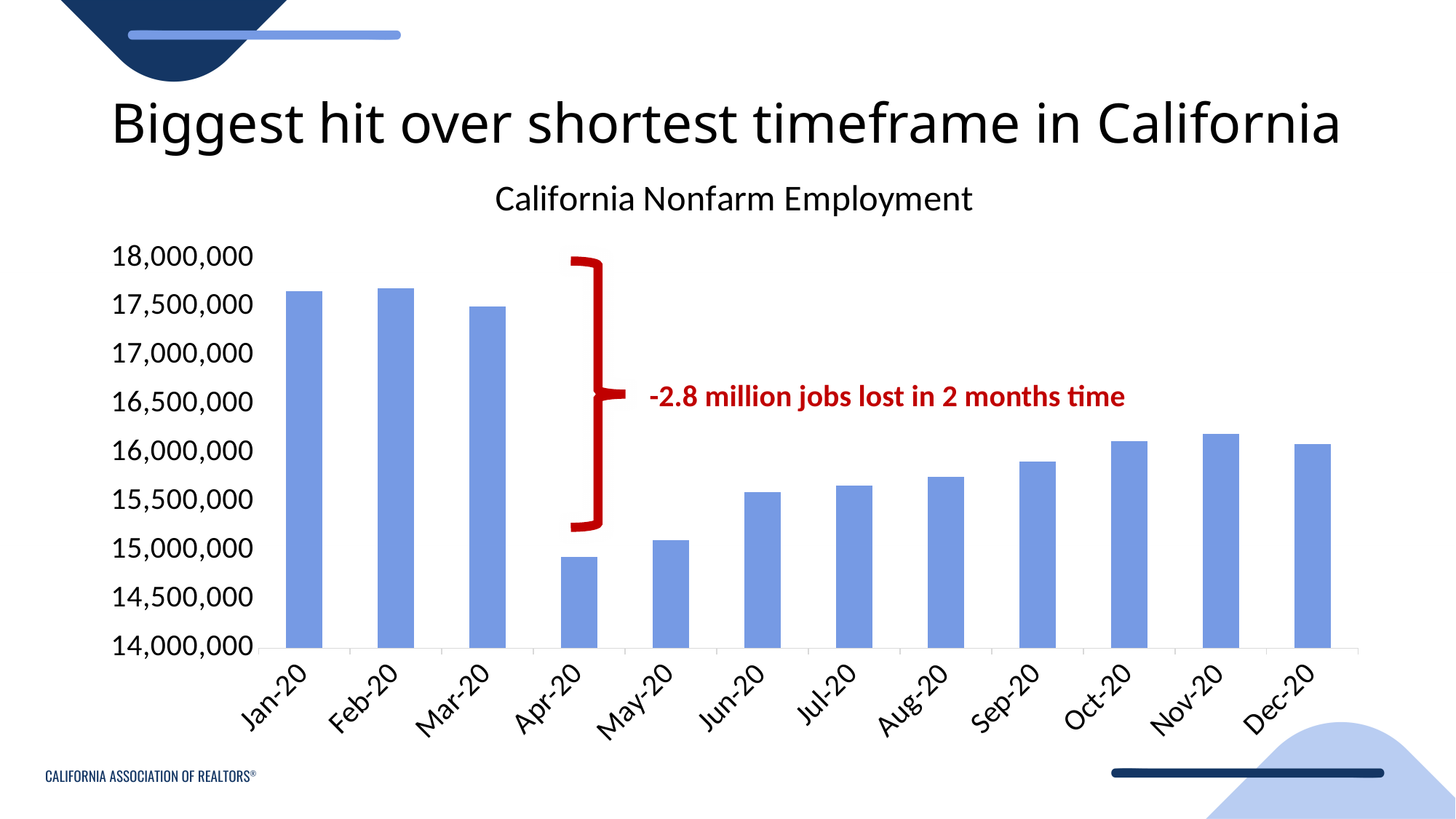
Which month has the lowest nonfarm employment in the chart? Apr-20 Which month has the higher nonfarm employment, Jan-20 or Apr-20? Jan-20 Which month has the higher nonfarm employment, May-20 or Jun-20? Jun-20 Is the value for Apr-20 greater or less than 15,000,000? less What is the title of the chart? California Nonfarm Employment Is the value for Nov-20 greater or less than 16,000,000? greater How many months are plotted on the x axis of the California Nonfarm Employment chart? 12 What kind of chart is shown on the slide? Bar chart Is the value for Sep-20 greater or less than 16,000,000? less What does the red annotation next to the bracket on the chart say? -2.8 million jobs lost in 2 months time Do the values rise or fall from Apr-20 to Nov-20? Rise